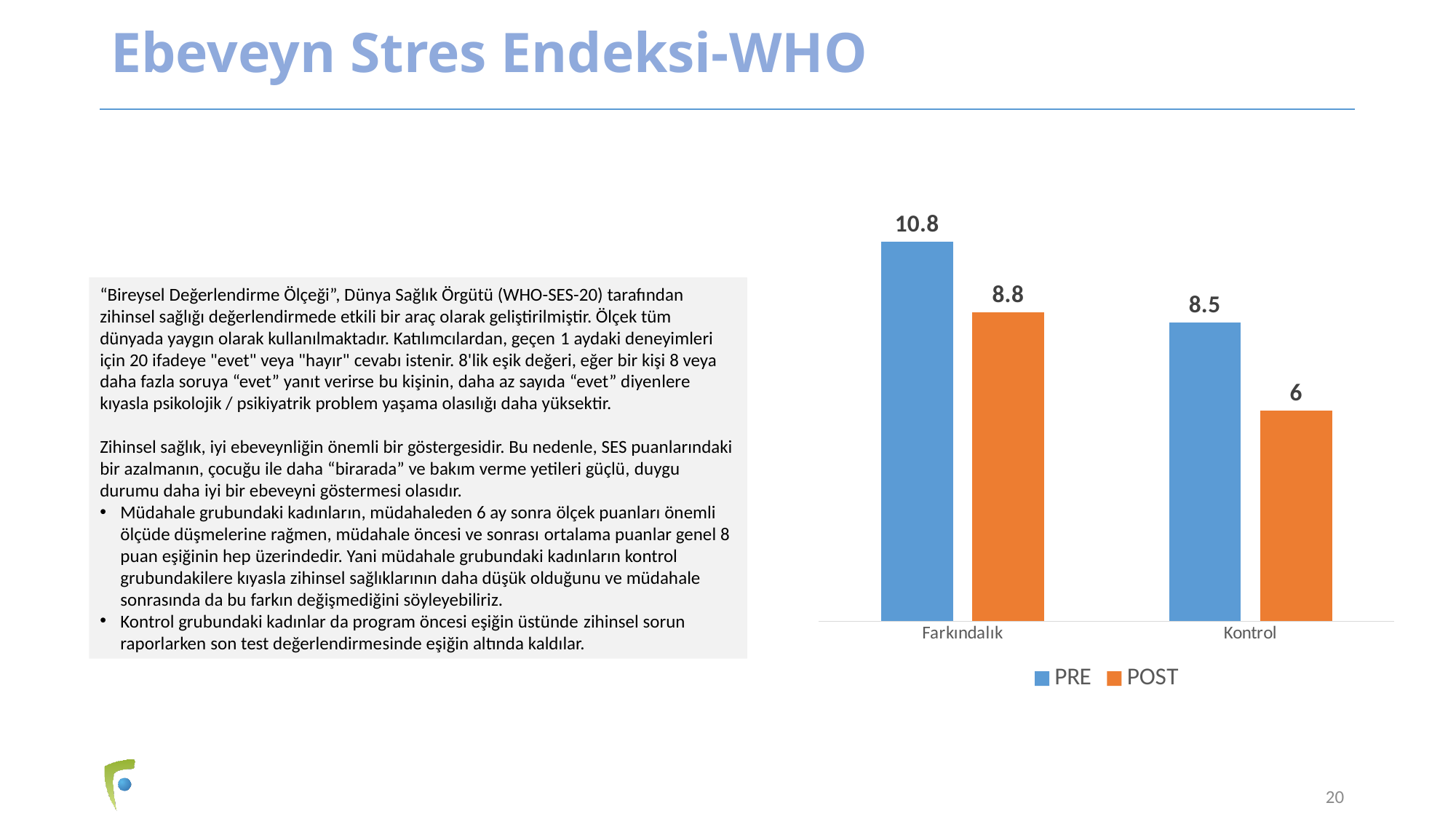
What kind of chart is shown on the slide? Bar chart How many series does the chart legend list? 2 Which category has the lowest POST value? Kontrol What is the POST value for Kontrol? 6 What is the difference between the PRE and POST values for Kontrol? 2.5 What is the difference between the PRE and POST values for Farkındalık? 2 Which is larger, the POST value for Farkındalık or the PRE value for Kontrol? POST value for Farkındalık What is the POST value for Farkındalık? 8.8 What is the PRE value for Farkındalık? 10.8 What is the PRE value for Kontrol? 8.5 Which category has the highest PRE value? Farkındalık How many categories are shown on the x axis of the chart? 2